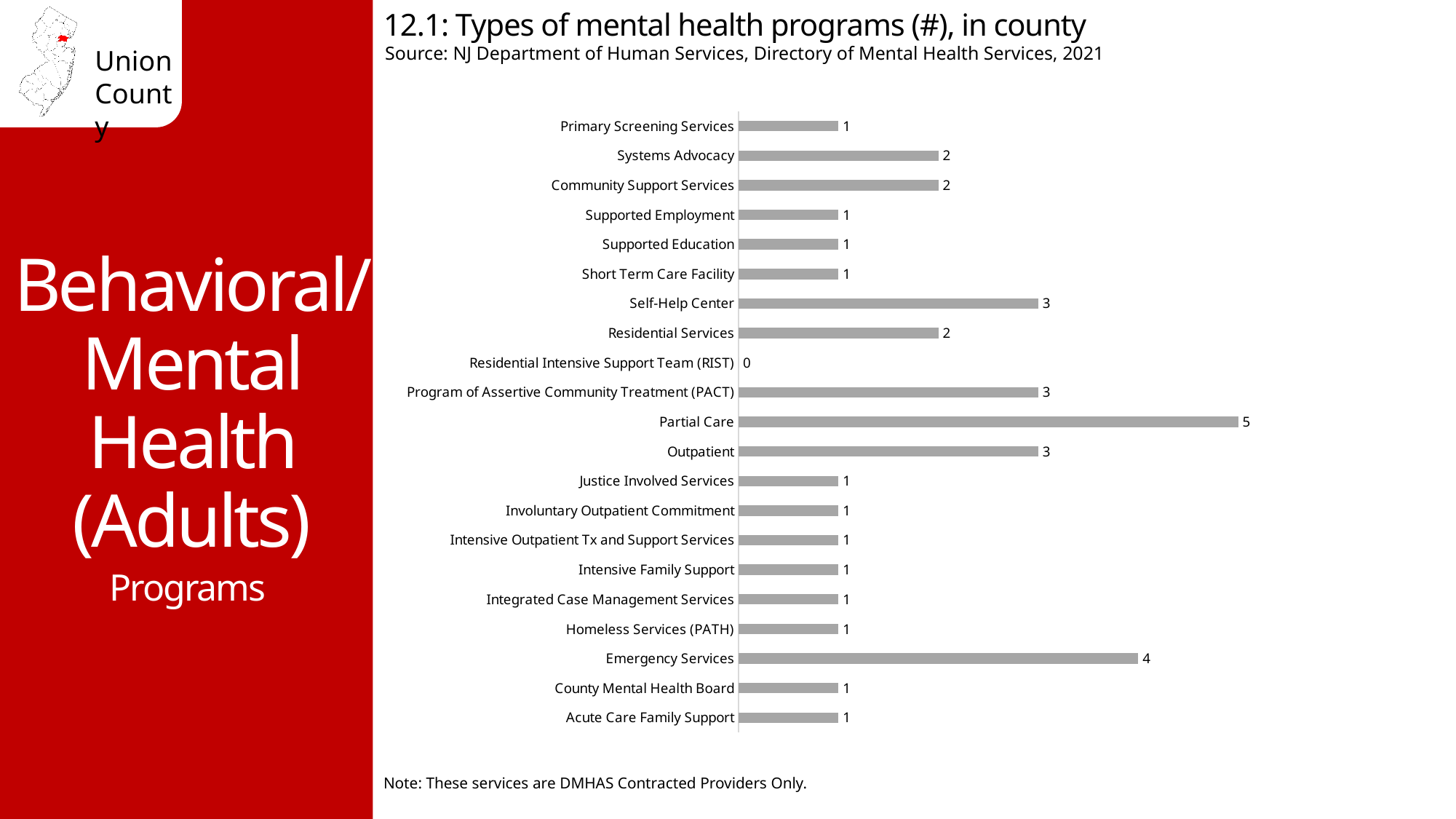
What kind of chart is shown on the slide? Bar chart What is the value for Emergency Services? 4 What is the difference between the values for Partial Care and Emergency Services? 1 How many Partial Care programs are shown in the chart? 5 What is the difference between the values for Outpatient and Systems Advocacy? 1 Which is larger, the value for Program of Assertive Community Treatment (PACT) or the value for Community Support Services? Program of Assertive Community Treatment (PACT) What is the source cited for the chart? NJ Department of Human Services, Directory of Mental Health Services, 2021 Which type of mental health program has the lowest count? Residential Intensive Support Team (RIST) What is the value for Residential Intensive Support Team (RIST)? 0 How many program types (categories) are shown in the chart? 21 Which type of mental health program has the highest count? Partial Care What is the value for Self-Help Center? 3